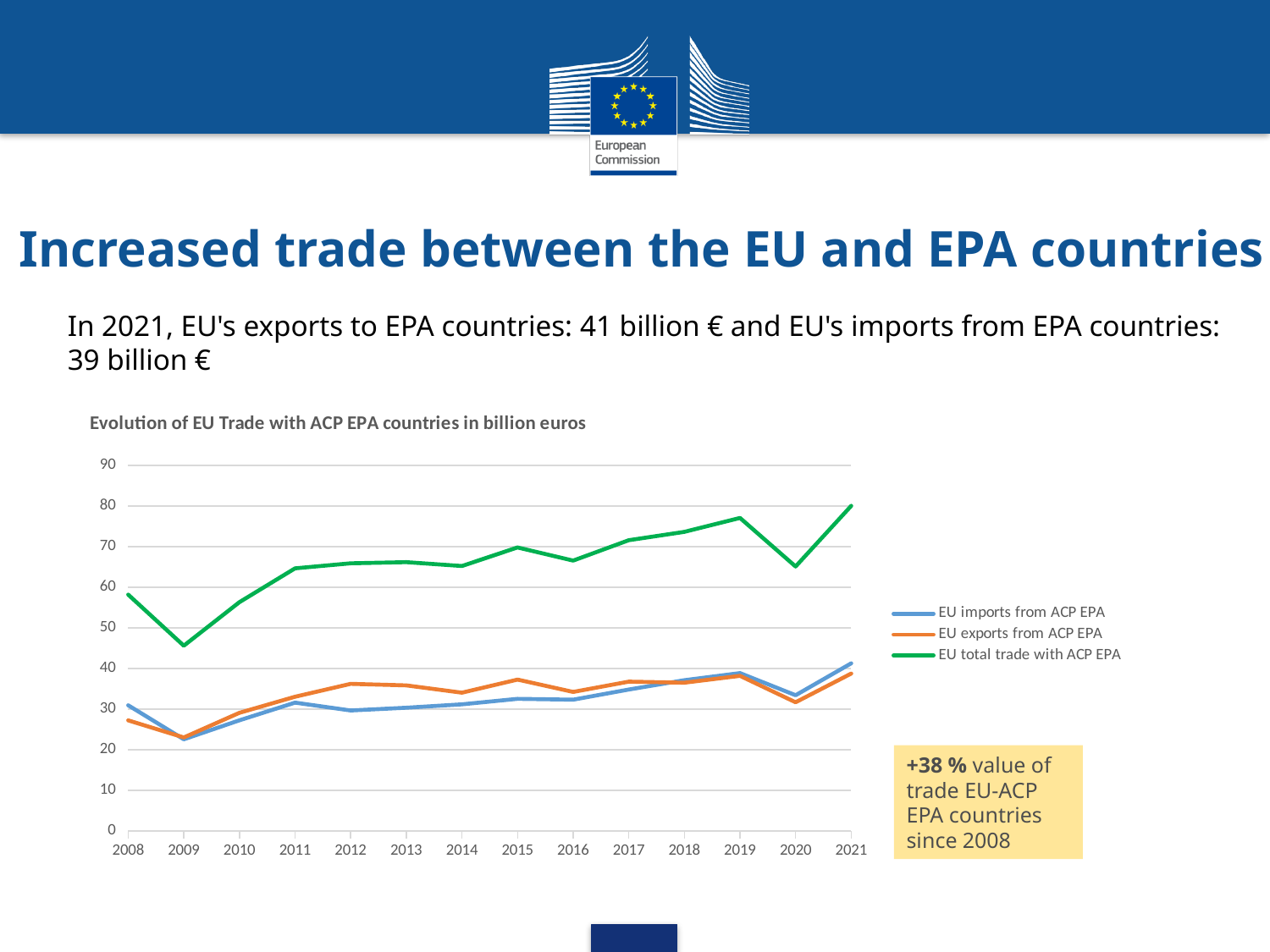
Is the value for EU total trade with ACP EPA in 2021 greater or less than 70? greater How many years are plotted along the x axis of the chart? 14 Is the value for EU imports from ACP EPA in 2009 greater or less than 30? less Does EU total trade with ACP EPA rise or fall from 2008 to 2009? fall How many series does the chart legend list? 3 Which year has the larger value for EU total trade with ACP EPA, 2019 or 2020? 2019 Is the value for EU exports from ACP EPA in 2012 greater or less than 30? greater What kind of chart is shown on the slide? line chart What is the title of the chart? Evolution of EU Trade with ACP EPA countries in billion euros In which year is EU total trade with ACP EPA at its highest? 2021 In which year is EU total trade with ACP EPA at its lowest? 2009